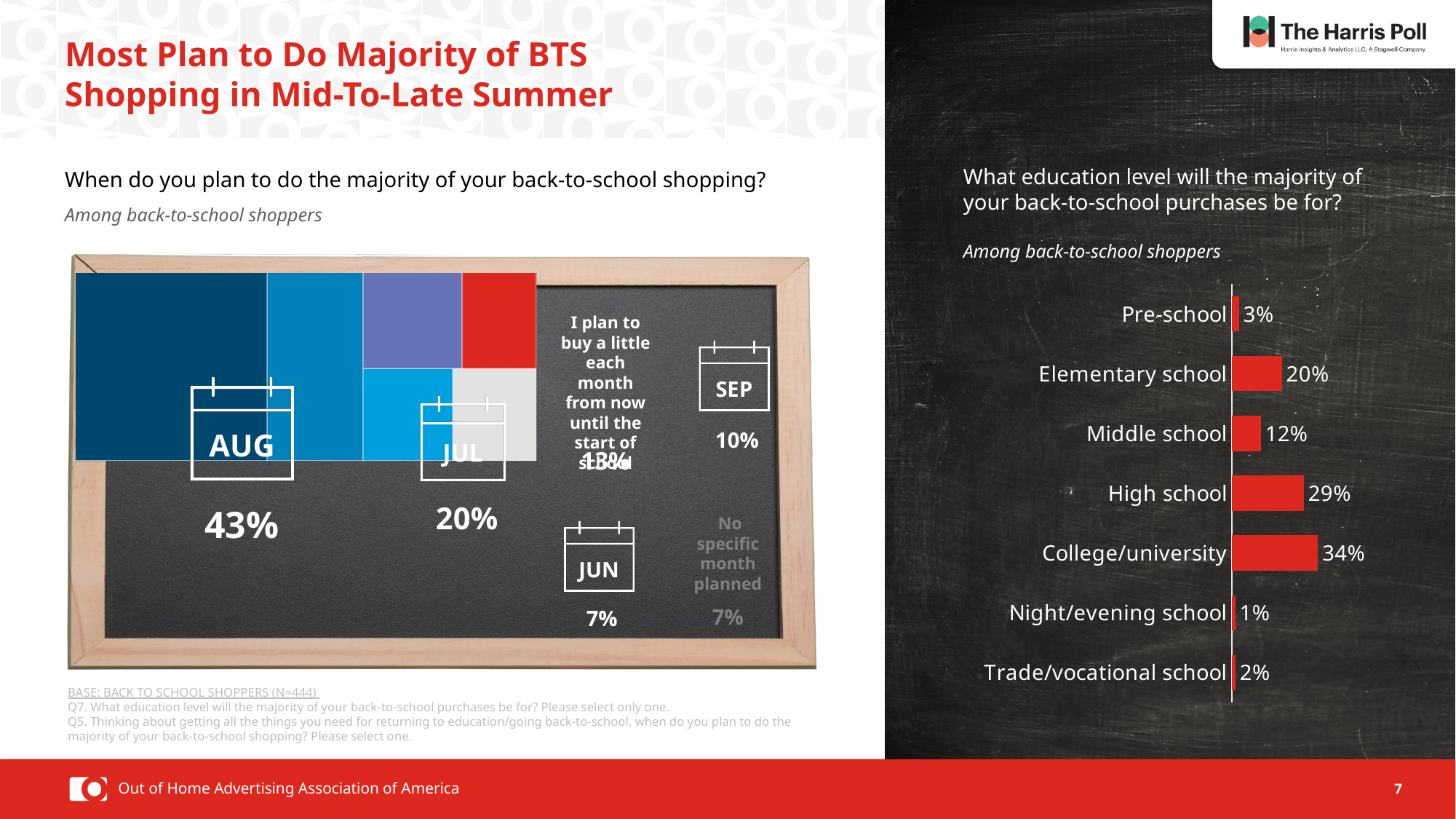
On the right-hand chart about education level, which education level has the lowest value? Night/evening school On the left-hand chart about when shoppers plan to do their back-to-school shopping, what percentage plan to shop in September? 10% On the left-hand chart about when shoppers plan to do their back-to-school shopping, what is the difference between the August and July values? 23% On the right-hand chart about education level, how many education levels are shown? 7 On the right-hand chart about education level, what is the value for High school? 29% On the left-hand chart about when shoppers plan to do their back-to-school shopping, which month has the highest share? AUG On the right-hand chart about education level, what is the difference between the values for College/university and High school? 5% On the right-hand chart about education level, which education level has the highest value? College/university On the right-hand chart about education level, which is larger: Elementary school or Middle school? Elementary school On the left-hand chart about when shoppers plan to do their back-to-school shopping, what percentage plan to shop in August? 43% On the right-hand chart about education level, what percentage of back-to-school purchases will be for college/university? 34% What kind of chart is the right-hand chart about education level? Bar chart